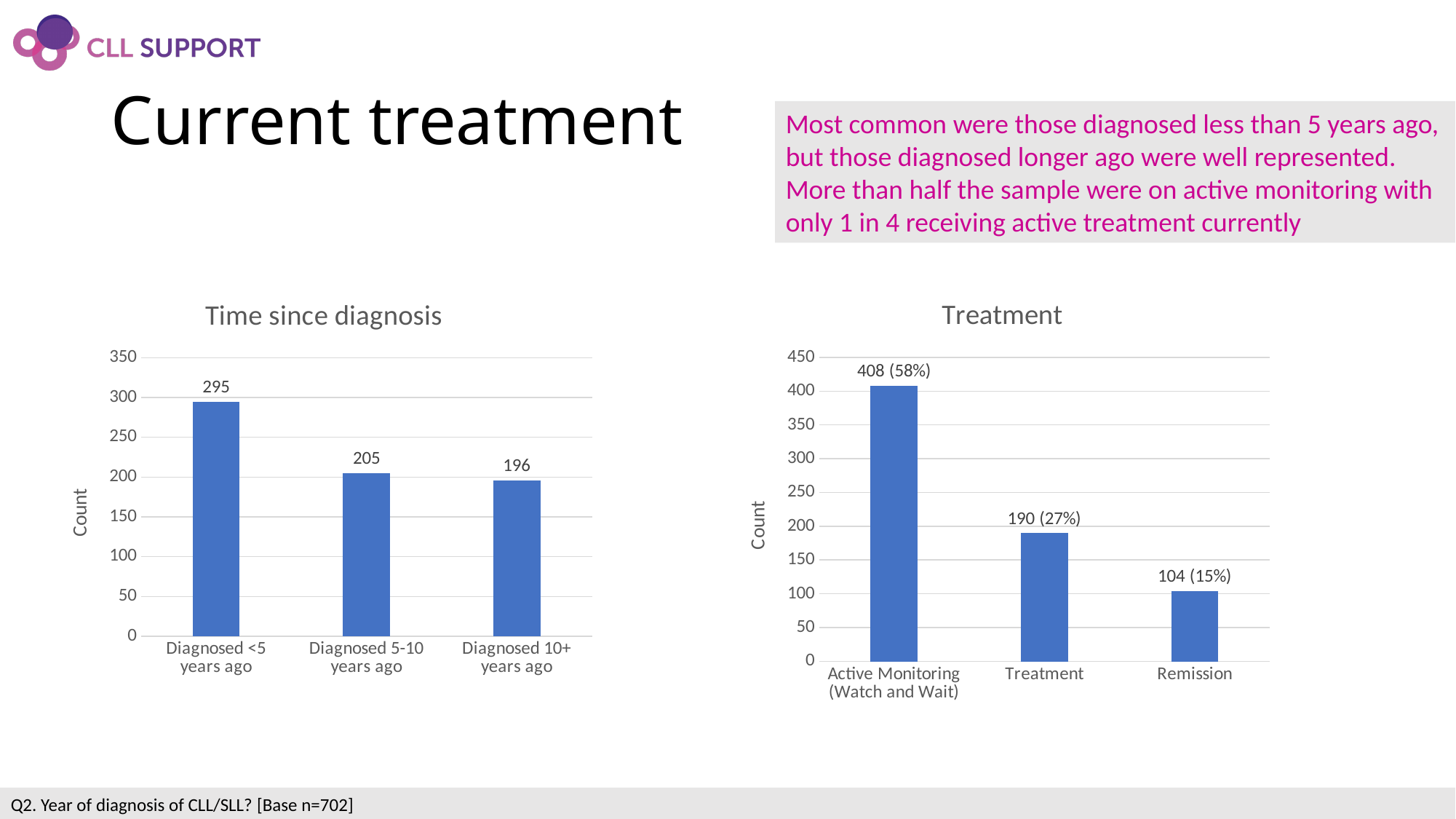
What type of chart is the 'Time since diagnosis' chart? bar chart How many categories are shown in the 'Treatment' chart? 3 In the 'Treatment' chart, what is the data label for 'Remission'? 104 (15%) In the 'Time since diagnosis' chart, what is the count for 'Diagnosed <5 years ago'? 295 In the 'Treatment' chart, which is larger: the count for 'Treatment' or the count for 'Remission'? Treatment In the 'Time since diagnosis' chart, what is the count for 'Diagnosed 10+ years ago'? 196 In the 'Treatment' chart, which category has the highest count? Active Monitoring (Watch and Wait) In the 'Time since diagnosis' chart, what is the difference between the counts for 'Diagnosed <5 years ago' and 'Diagnosed 5-10 years ago'? 90 In the 'Time since diagnosis' chart, do the counts rise or fall from left to right across the categories? fall In the 'Treatment' chart, what is the data label for 'Active Monitoring (Watch and Wait)'? 408 (58%) In the 'Treatment' chart, what is the difference in count between 'Treatment' and 'Remission'? 86 In the 'Time since diagnosis' chart, which category has the lowest count? Diagnosed 10+ years ago